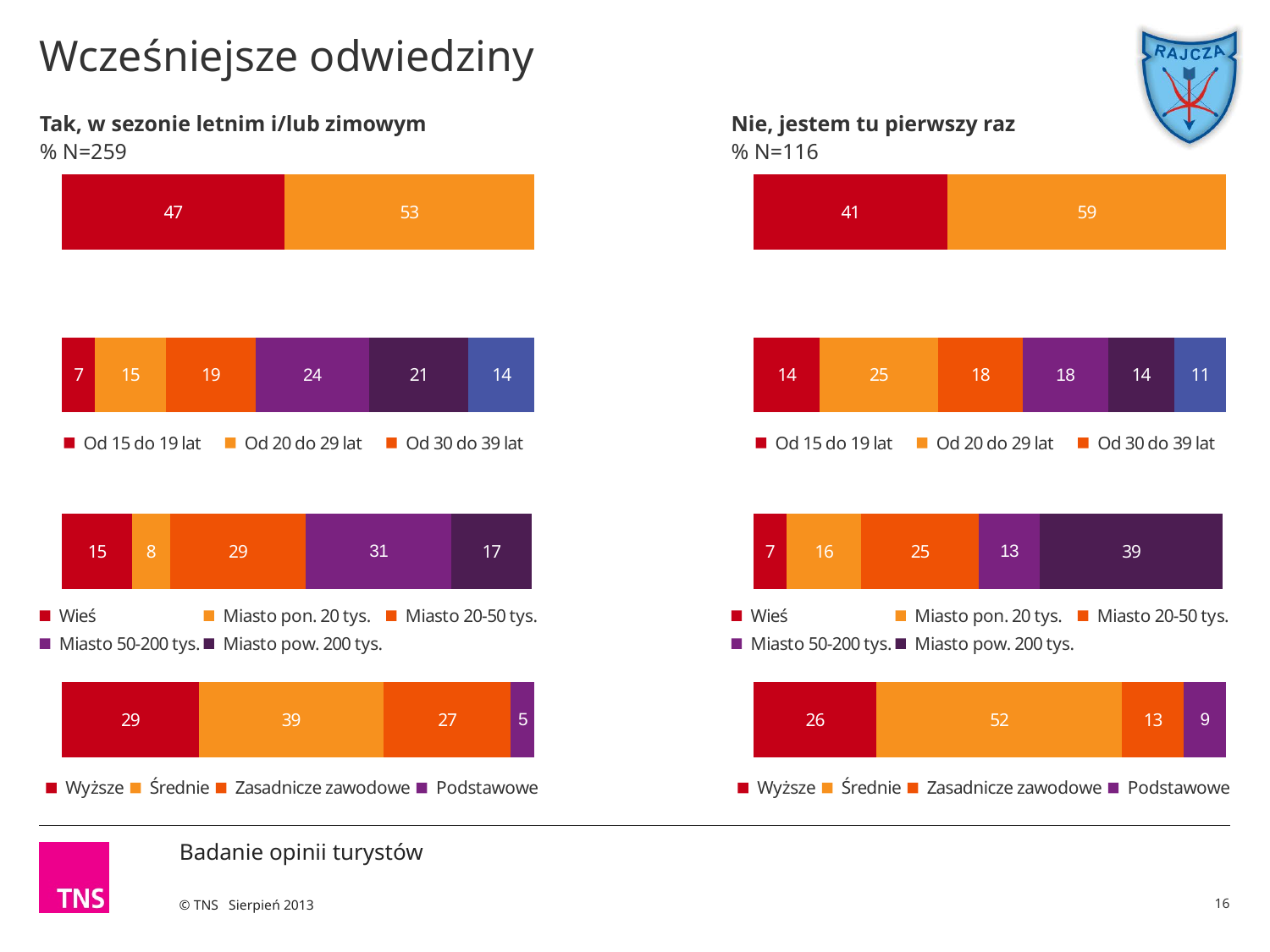
In the 'Tak, w sezonie letnim i/lub zimowym' chart, which is larger in the residence bar: Wieś or Miasto pon. 20 tys.? Wieś In the 'Tak, w sezonie letnim i/lub zimowym' chart, which education category has the lowest value? Podstawowe What type of chart is used on this slide? Bar chart Which chart has the larger value for Od 15 do 19 lat: 'Tak, w sezonie letnim i/lub zimowym' or 'Nie, jestem tu pierwszy raz'? Nie, jestem tu pierwszy raz In the 'Nie, jestem tu pierwszy raz' chart, what is the value for Średnie in the education bar? 52 What is the total of the education bar in the 'Tak, w sezonie letnim i/lub zimowym' chart? 100 In the 'Nie, jestem tu pierwszy raz' chart, what is the value for Od 20 do 29 lat in the age bar? 25 How many segments does the education bar in the 'Tak, w sezonie letnim i/lub zimowym' chart have? 4 In the 'Tak, w sezonie letnim i/lub zimowym' chart, what is the value for Wyższe in the education bar? 29 In the 'Nie, jestem tu pierwszy raz' chart, what is the difference between Średnie and Wyższe in the education bar? 26 In the 'Nie, jestem tu pierwszy raz' chart, which place-of-residence category has the highest value? Miasto pow. 200 tys. In the 'Tak, w sezonie letnim i/lub zimowym' chart, which place-of-residence category has the highest value? Miasto 50-200 tys.